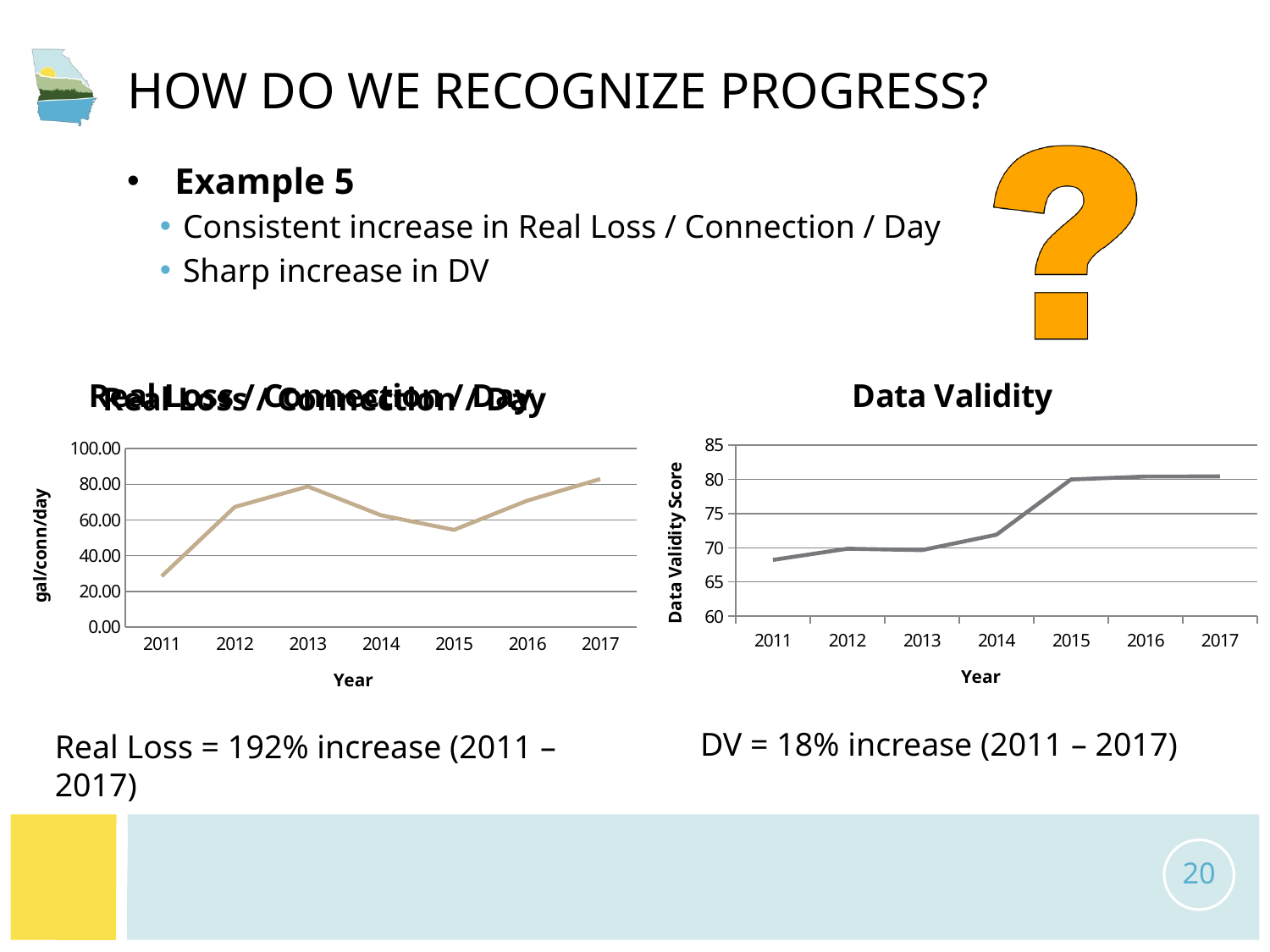
In the Data Validity chart, which year has the lowest score? 2011 In the Real Loss / Connection / Day chart, which year has the lowest value? 2011 In the Real Loss / Connection / Day chart, is the value for 2015 greater or less than 60.00? less In the Data Validity chart, does the score generally rise or fall from 2011 to 2017? rise In the Data Validity chart, is the score for 2015 greater or less than 75? greater In the Real Loss / Connection / Day chart, is the value for 2011 greater or less than 40.00? less In the Real Loss / Connection / Day chart, how many years are plotted on the x axis? 7 In the Data Validity chart, how many years are plotted on the x axis? 7 In the Real Loss / Connection / Day chart, which is larger, the value for 2012 or the value for 2011? 2012 What kind of chart is the Real Loss / Connection / Day chart? line chart What kind of chart is the Data Validity chart? line chart